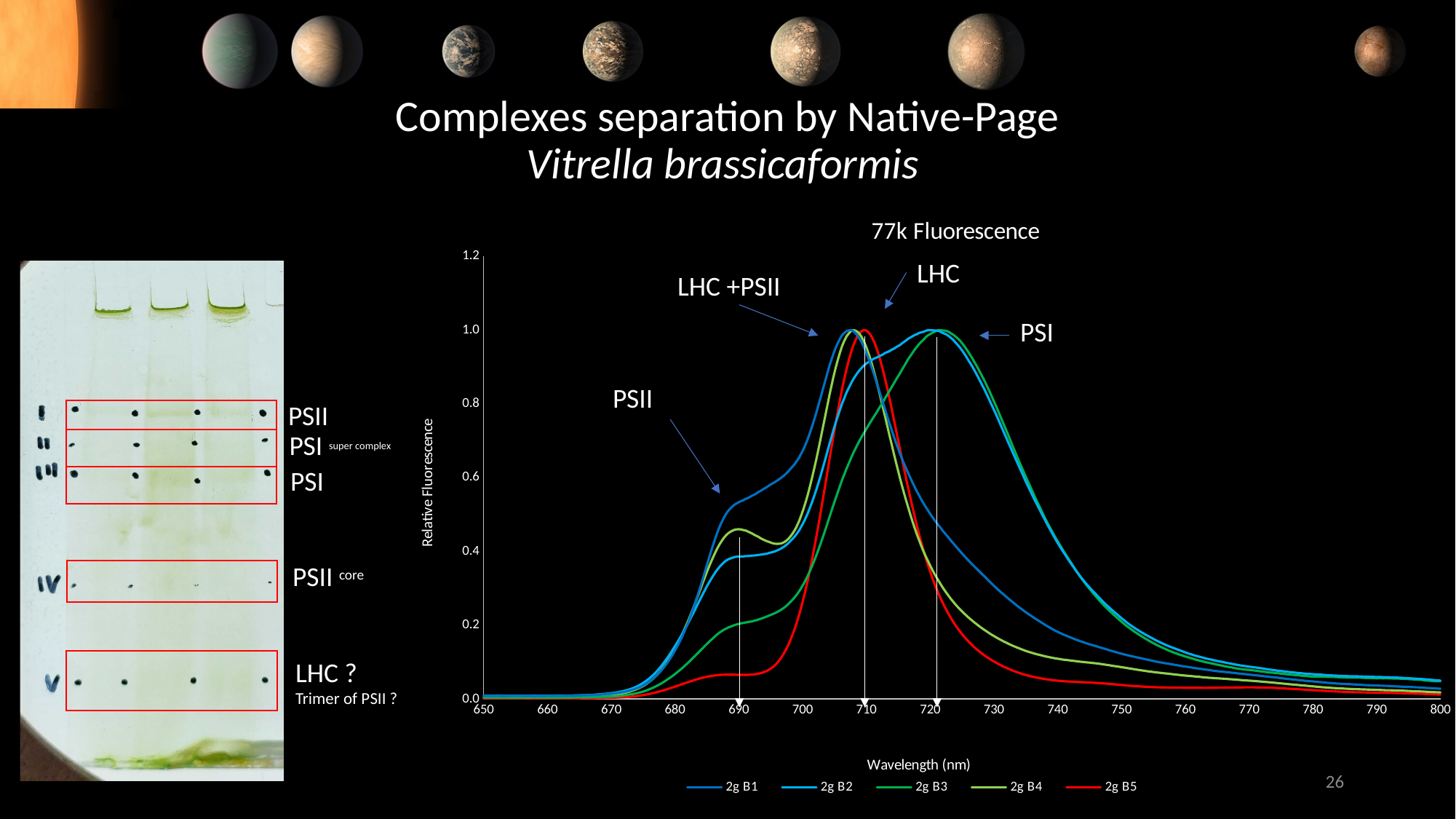
In the 77k Fluorescence chart, do the values for 2g B5 rise or fall between 710 nm and 800 nm? fall In the 77k Fluorescence chart, at 690 nm, which is larger: the value for 2g B1 or the value for 2g B5? 2g B1 In the 77k Fluorescence chart, is the value for 2g B5 at 690 nm greater or less than 0.2? less What is the title of the chart on the slide? 77k Fluorescence In the 77k Fluorescence chart, is the value for 2g B5 at 740 nm greater or less than 0.2? less In the 77k Fluorescence chart, which series has the lowest value at 690 nm? 2g B5 What is the label of the x axis of the 77k Fluorescence chart? Wavelength (nm) In the 77k Fluorescence chart, at 740 nm, which is larger: the value for 2g B2 or the value for 2g B5? 2g B2 In the 77k Fluorescence chart, is the value for 2g B3 at 760 nm greater or less than 0.2? less What kind of chart is shown on the slide? line chart How many series does the legend of the 77k Fluorescence chart list? 5